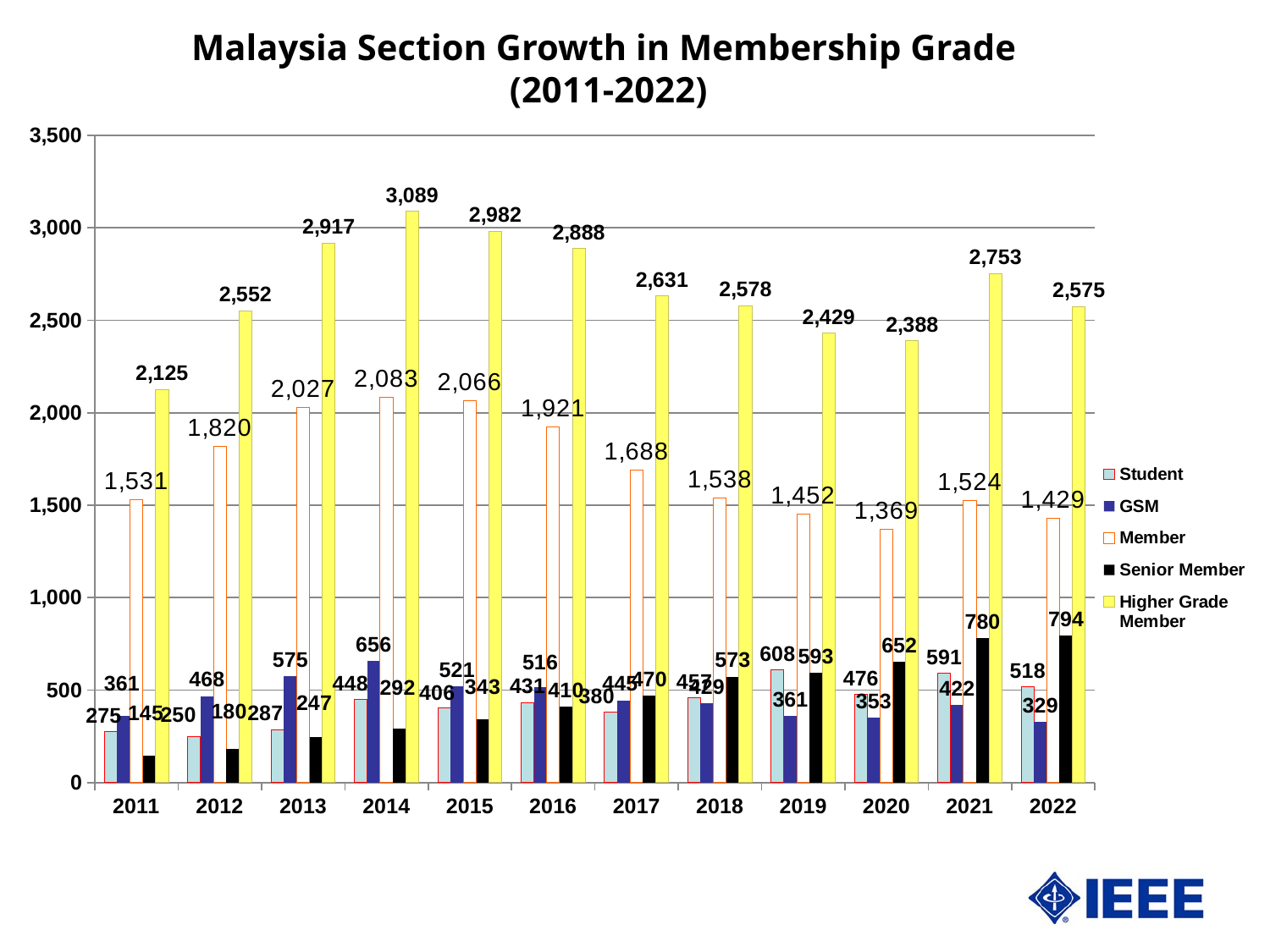
What is the difference between the Higher Grade Member values for 2021 and 2020? 365 In which year is the Higher Grade Member value lowest? 2011 Do the Senior Member values generally rise or fall from 2011 to 2022? rise How many years are shown on the x axis? 12 In which year is the Higher Grade Member value highest? 2014 What is the Higher Grade Member value for 2014? 3,089 How many series does the legend list? 5 What is the Senior Member value for 2021? 780 What is the Member value for 2020? 1,369 What is the title of the chart? Malaysia Section Growth in Membership Grade (2011-2022) In 2022, which is larger: Senior Member or Student? Senior Member What kind of chart is shown on the slide? bar chart